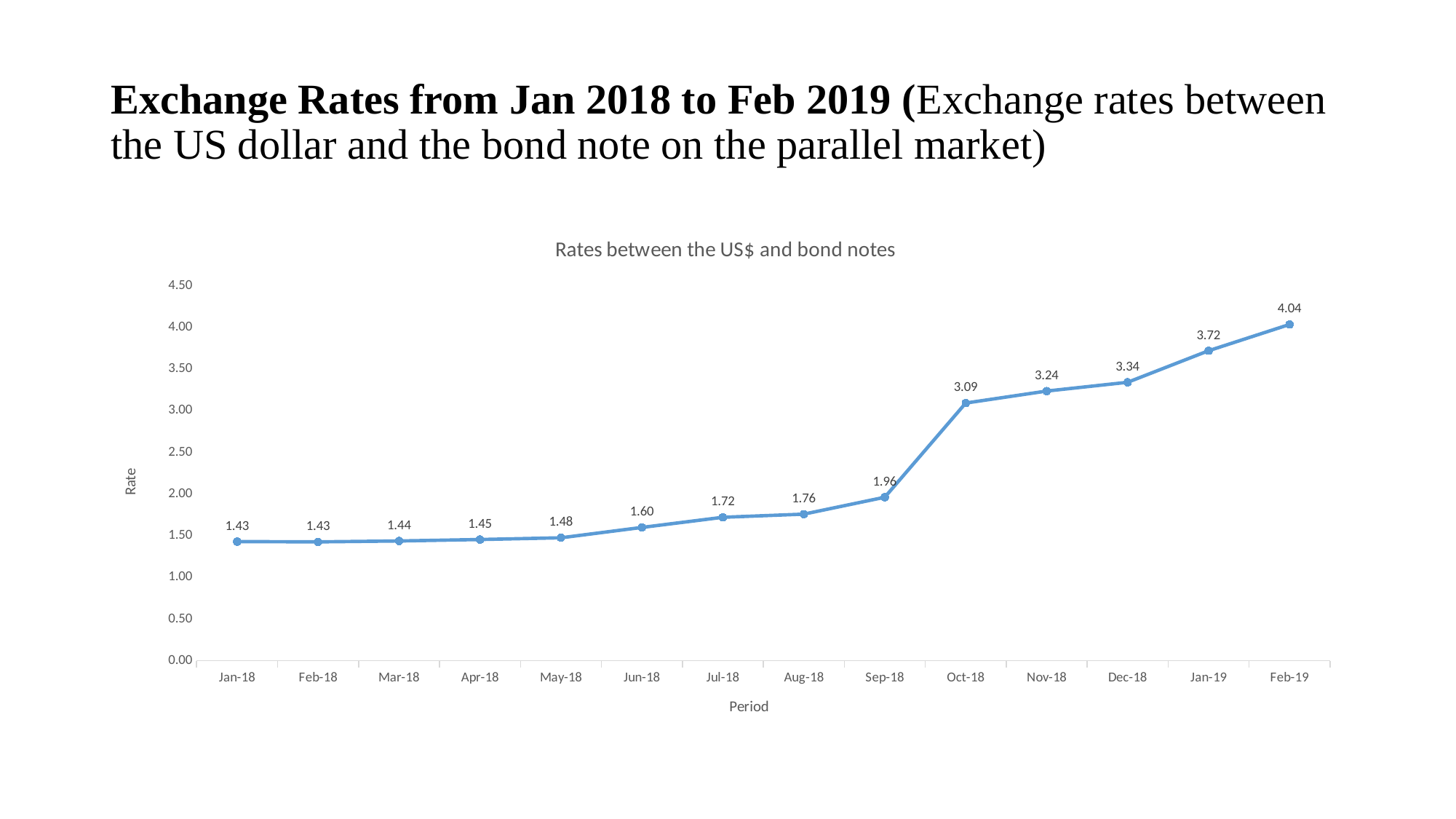
What is the rate for Jun-18? 1.60 Is the rate for Jan-19 greater or less than 3.50? greater What is the rate for Oct-18? 3.09 What is the title of the chart? Rates between the US$ and bond notes Which is larger, the rate for Dec-18 or the rate for Nov-18? Dec-18 What is the difference between the rates for Oct-18 and Sep-18? 1.13 Which period has the highest rate? Feb-19 What is the difference between the rates for Feb-19 and Jan-19? 0.32 Do the rates rise or fall from Jan-18 to Feb-19? Rise What kind of chart is shown on the slide? Line chart What is the rate for Feb-19? 4.04 How many periods are plotted on the x axis? 14